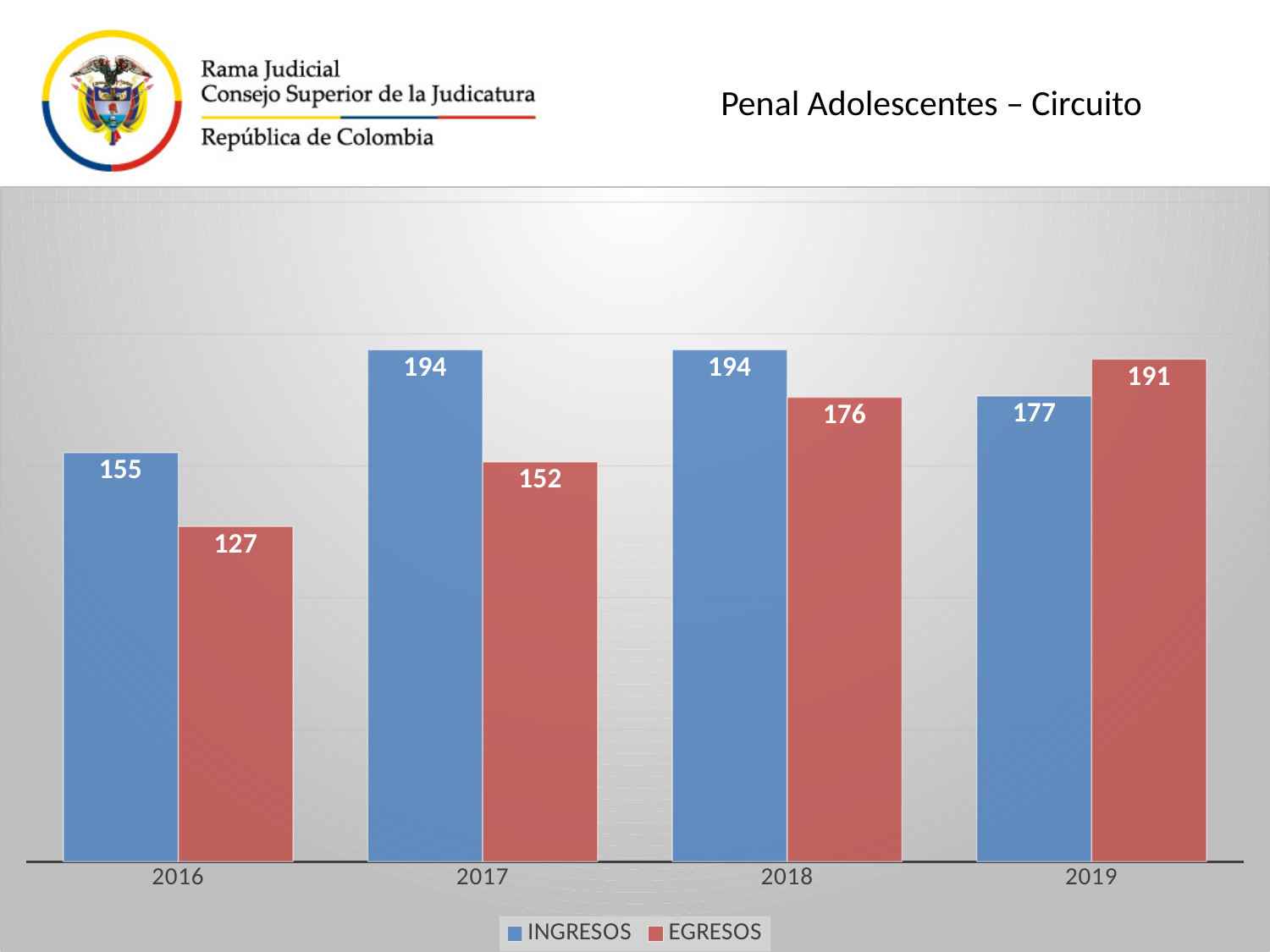
What is the EGRESOS value for 2018? 176 What is the INGRESOS value for 2016? 155 Do the EGRESOS values rise or fall from 2016 to 2019? rise In 2019, which is larger, INGRESOS or EGRESOS? EGRESOS What is the difference between EGRESOS in 2019 and EGRESOS in 2016? 64 Which year has the lowest EGRESOS value? 2016 What is the difference between INGRESOS and EGRESOS in 2017? 42 What kind of chart is shown on the slide? bar chart What is the EGRESOS value for 2019? 191 How many series does the legend list? 2 How many years are shown on the x axis? 4 Which year has the highest EGRESOS value? 2019